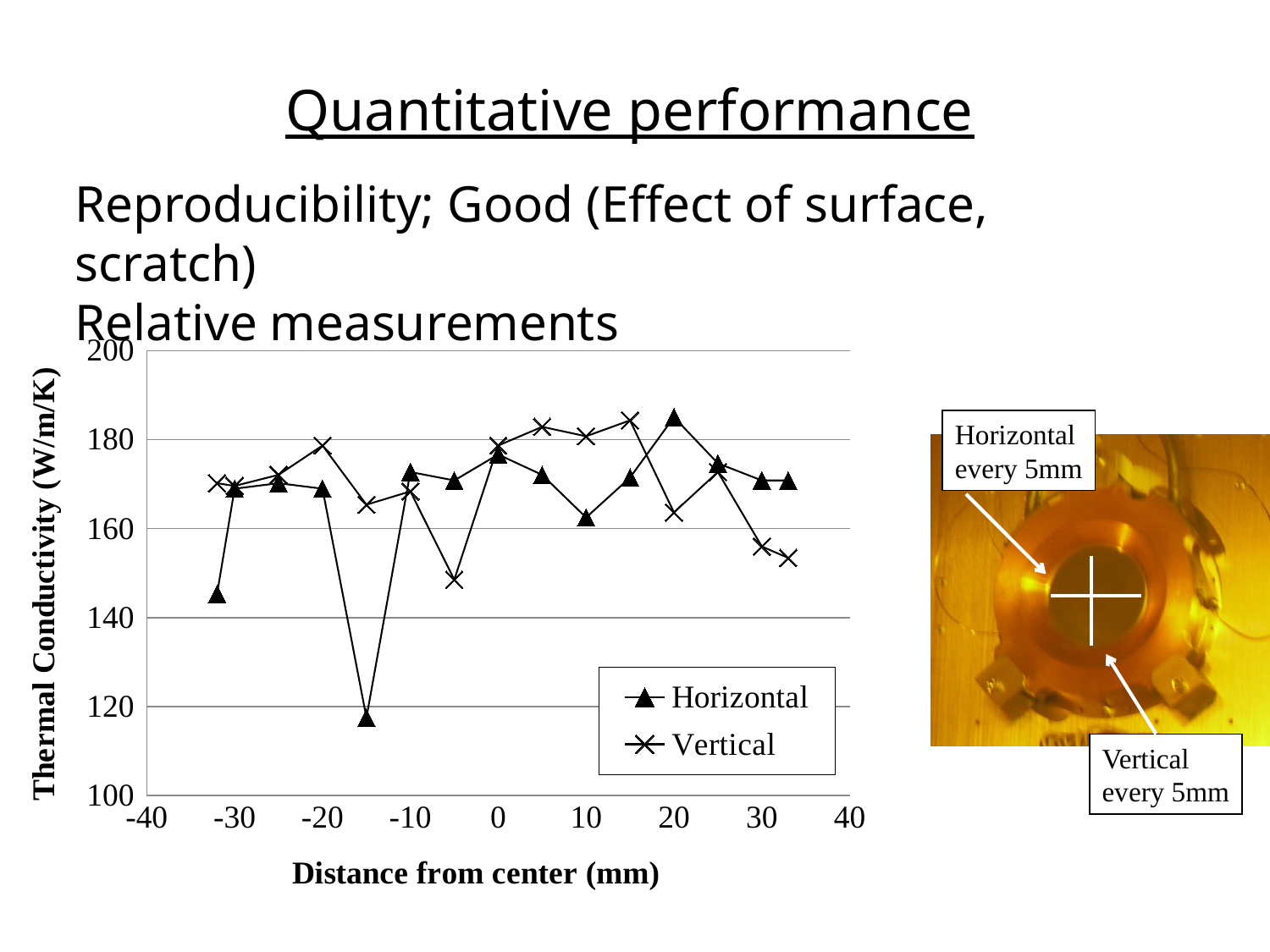
How many series does the chart legend list? 2 Is the Horizontal value at -15 mm greater or less than 120? less At -15 mm, which series has the higher thermal conductivity, Horizontal or Vertical? Vertical Is the Horizontal value at 20 mm greater or less than 180? greater What kind of chart is shown on the slide? Line chart Is the Vertical value at 15 mm greater or less than 180? greater At which distance from center does the Horizontal series reach its lowest value? -15 mm What are the two series named in the chart legend? Horizontal and Vertical At 20 mm, which series has the higher thermal conductivity, Horizontal or Vertical? Horizontal At which distance from center does the Horizontal series reach its highest value? 20 mm What is the title of the chart's x axis? Distance from center (mm)